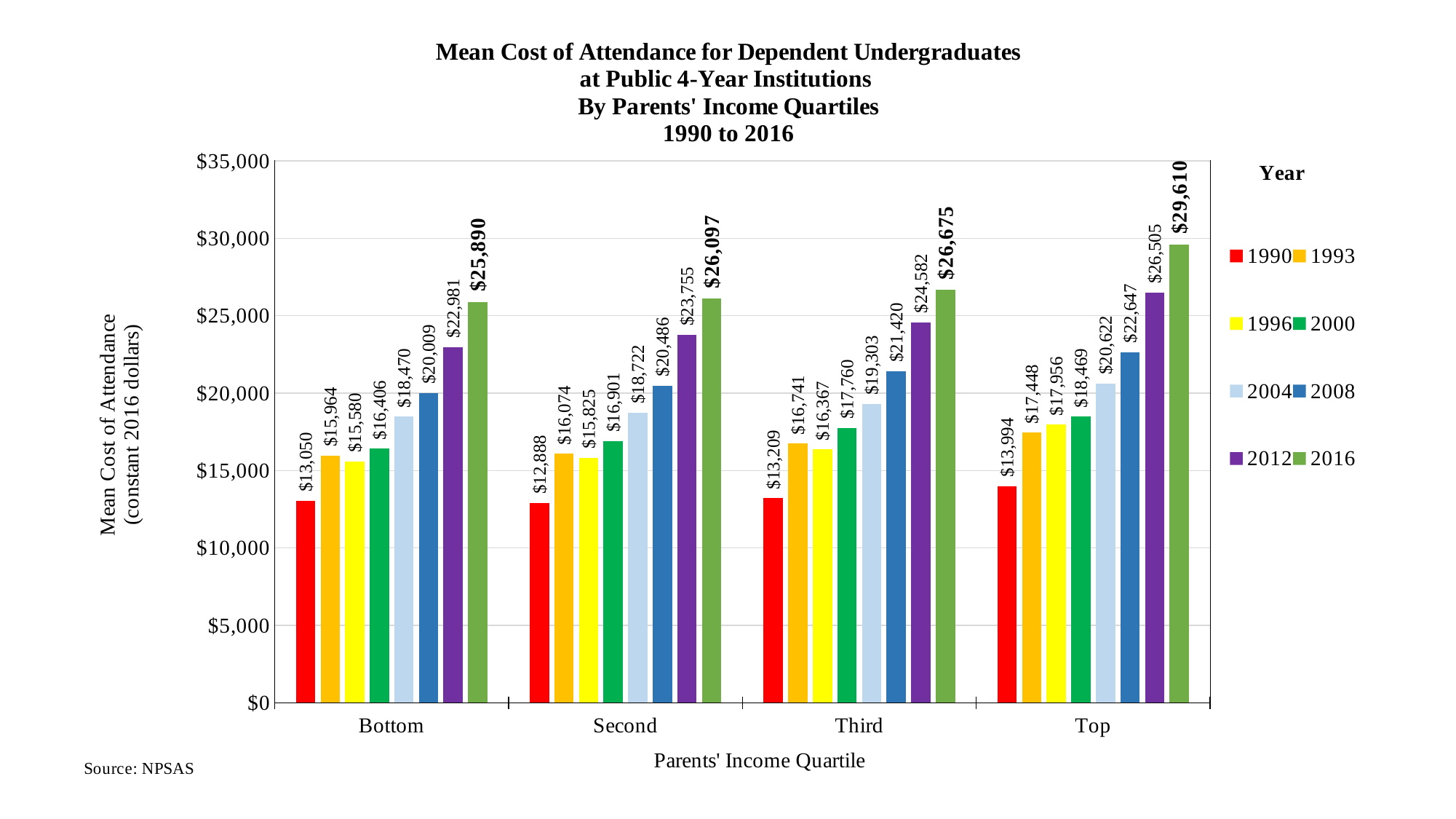
What is the difference between the 2012 mean cost of attendance for the Top quartile and the Third quartile? $1,923 Which parents' income quartile has the highest mean cost of attendance in 2016? Top How many parents' income quartiles are shown on the x axis? 4 What is the mean cost of attendance for the Second income quartile in 2008? $20,486 What is the mean cost of attendance for the Top income quartile in 2016? $29,610 What is the difference between the 2016 mean cost of attendance for the Top quartile and the Bottom quartile? $3,720 What kind of chart is shown on the slide? Bar chart How many years does the legend list? 8 Which parents' income quartile has the lowest mean cost of attendance in 1990? Second Is the 2012 mean cost of attendance for the Bottom quartile greater or less than $20,000? greater In 2004, which has a higher mean cost of attendance: the Third quartile or the Top quartile? Top What is the mean cost of attendance for the Bottom income quartile in 1990? $13,050